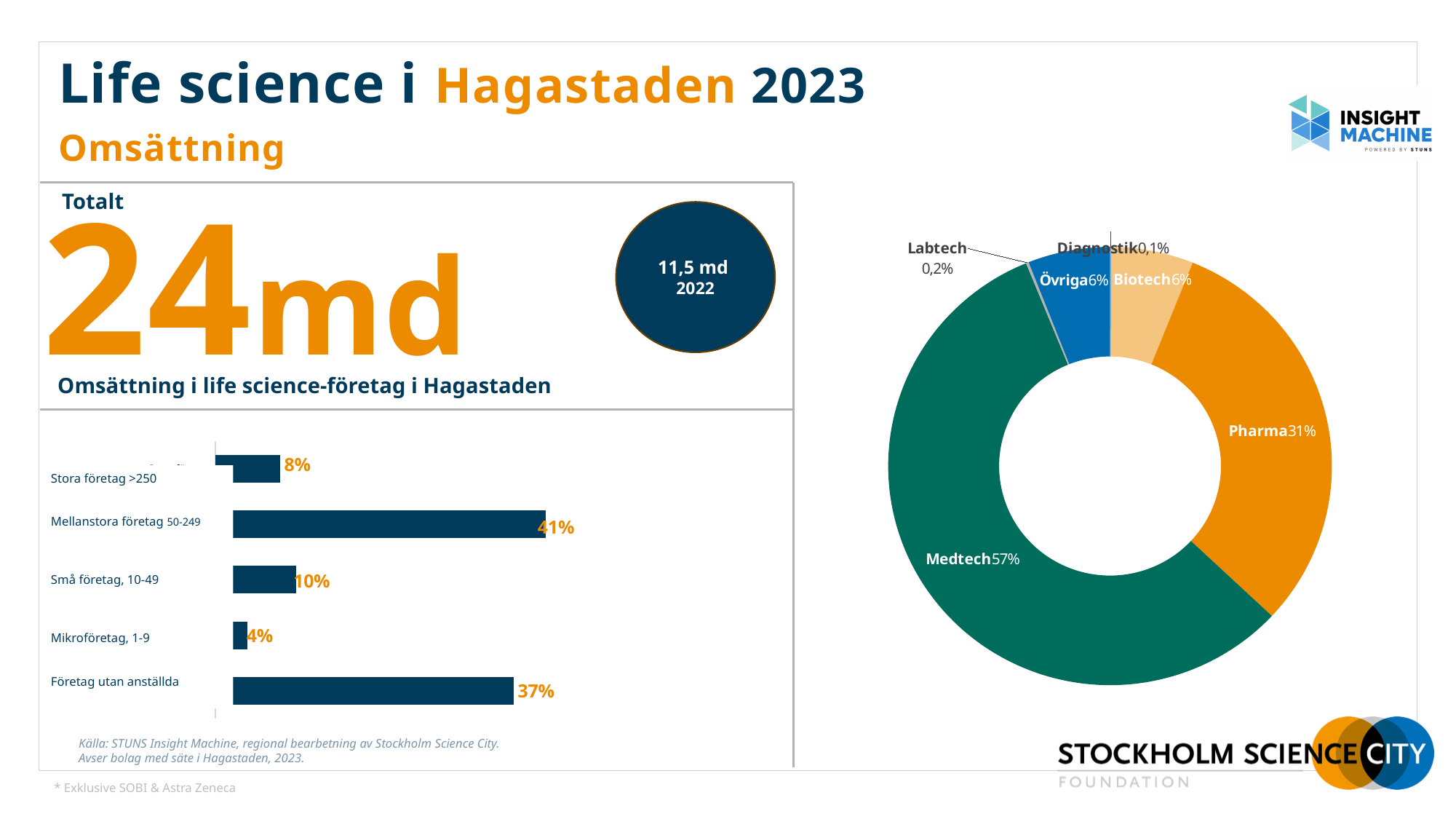
In the donut chart on the right, which sector has the smallest share? Diagnostik In the bar chart on the left, what is the value for Företag utan anställda? 37% In the bar chart on the left, what is the value for Mellanstora företag 50-249? 41% In the donut chart on the right, what share does Medtech have? 57% What kind of chart is shown on the left side of the slide? Bar chart In the donut chart on the right, what is the value for Labtech? 0,2% In the bar chart on the left, which category has the highest value? Mellanstora företag 50-249 In the bar chart on the left, what is the difference between Mellanstora företag 50-249 and Företag utan anställda? 4% In the donut chart on the right, what is the difference between Medtech and Pharma? 26% How many categories does the bar chart on the left show? 5 In the bar chart on the left, which category has the lowest value? Mikroföretag, 1-9 In the bar chart on the left, which is larger: Stora företag >250 or Små företag, 10-49? Små företag, 10-49